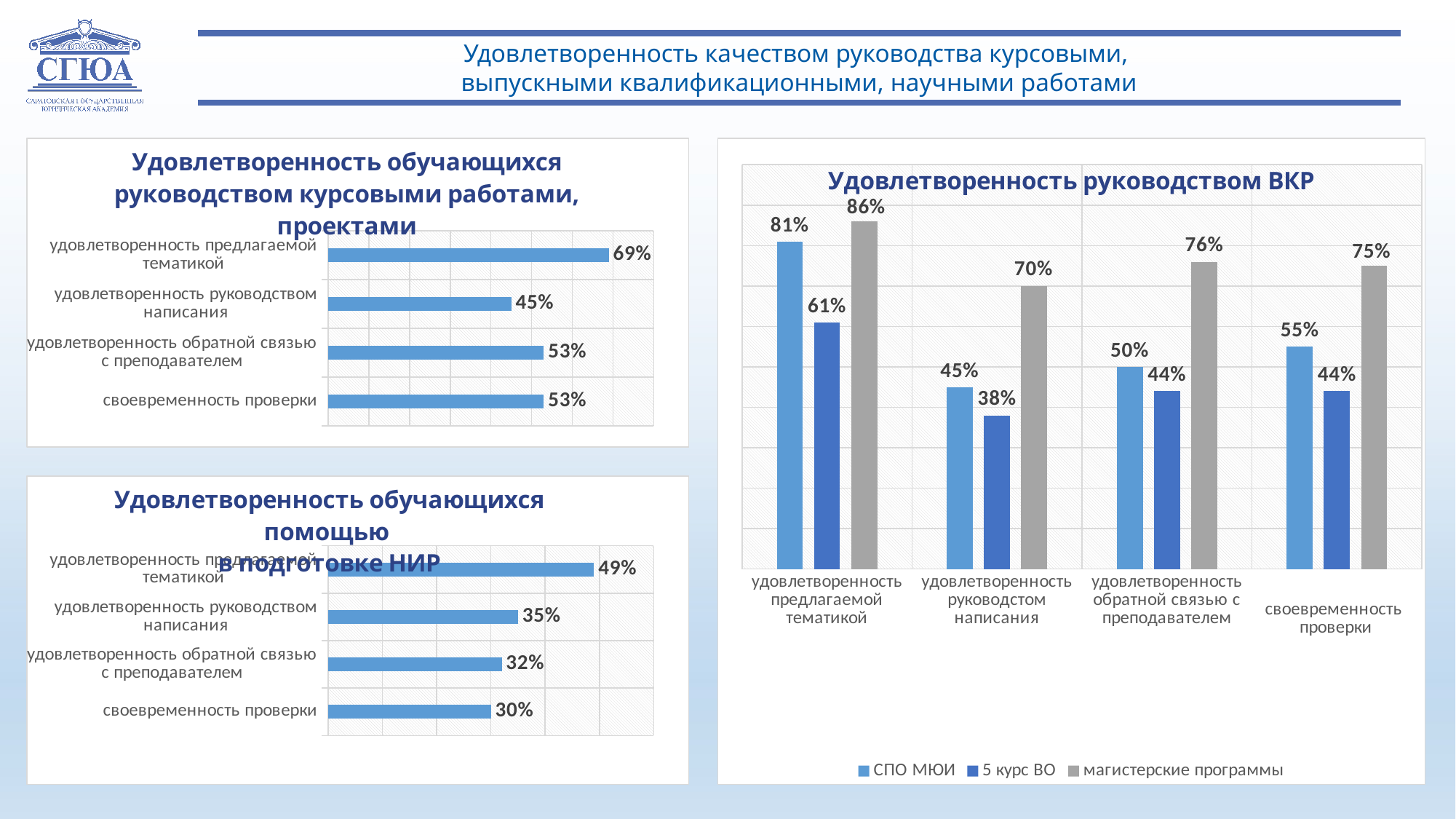
In the chart 'Удовлетворенность руководством ВКР', what is the value for 'магистерские программы' in 'удовлетворенность руководстом написания'? 70% In the chart 'Удовлетворенность руководством ВКР', how many series does the legend list? 3 What type of chart is 'Удовлетворенность обучающихся помощью в подготовке НИР'? bar chart In the chart 'Удовлетворенность обучающихся помощью в подготовке НИР', how many categories are shown? 4 In the chart 'Удовлетворенность руководством ВКР', which is larger for 'своевременность проверки': 'СПО МЮИ' or '5 курс ВО'? СПО МЮИ In the chart 'Удовлетворенность обучающихся помощью в подготовке НИР', what is the value for 'своевременность проверки'? 30% In the chart 'Удовлетворенность руководством ВКР', which series has the highest value for 'удовлетворенность предлагаемой тематикой'? магистерские программы In the chart 'Удовлетворенность обучающихся руководством курсовыми работами, проектами', what is the value for 'удовлетворенность предлагаемой тематикой'? 69% In the chart 'Удовлетворенность обучающихся руководством курсовыми работами, проектами', which category has the lowest value? удовлетворенность руководством написания In the chart 'Удовлетворенность руководством ВКР', what is the difference between 'магистерские программы' and '5 курс ВО' for 'удовлетворенность обратной связью с преподавателем'? 32% In the chart 'Удовлетворенность обучающихся помощью в подготовке НИР', which category has the highest value? удовлетворенность предлагаемой тематикой In the chart 'Удовлетворенность обучающихся руководством курсовыми работами, проектами', what is the difference between 'удовлетворенность предлагаемой тематикой' and 'удовлетворенность руководством написания'? 24%